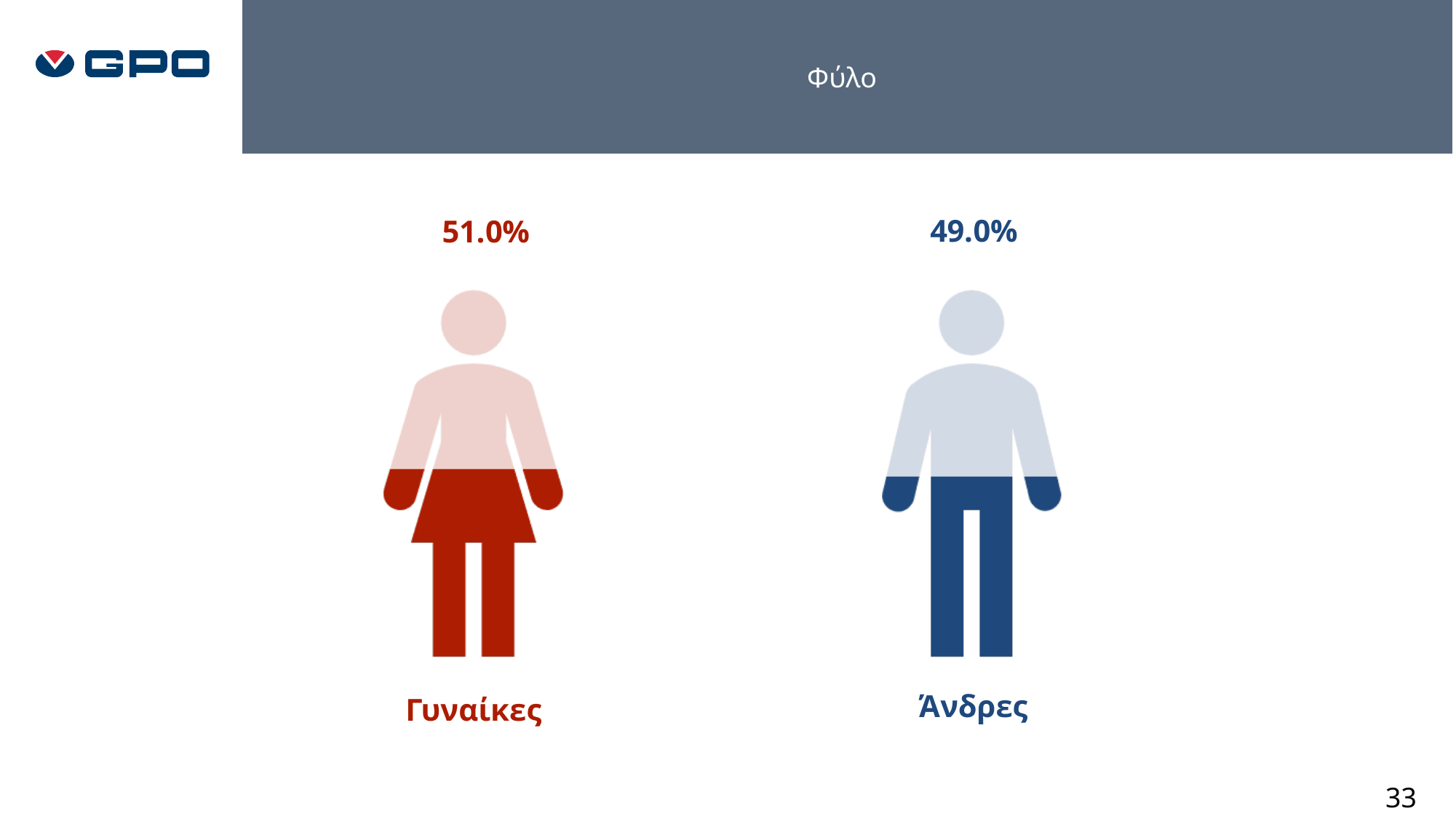
What is the value shown for Γυναίκες? 51.0% Is the value for Γυναίκες greater or less than 50%? greater What is the total of the two percentages shown? 100.0% How many categories are shown on the slide? 2 Is the value for Άνδρες larger or smaller than the value for Γυναίκες? smaller Which category has the higher value, Γυναίκες or Άνδρες? Γυναίκες What colour is used for the Άνδρες figure? Blue What is the title of the chart? Φύλο What is the difference between the values for Γυναίκες and Άνδρες? 2.0% What is the value shown for Άνδρες? 49.0% Which category has the lower value? Άνδρες